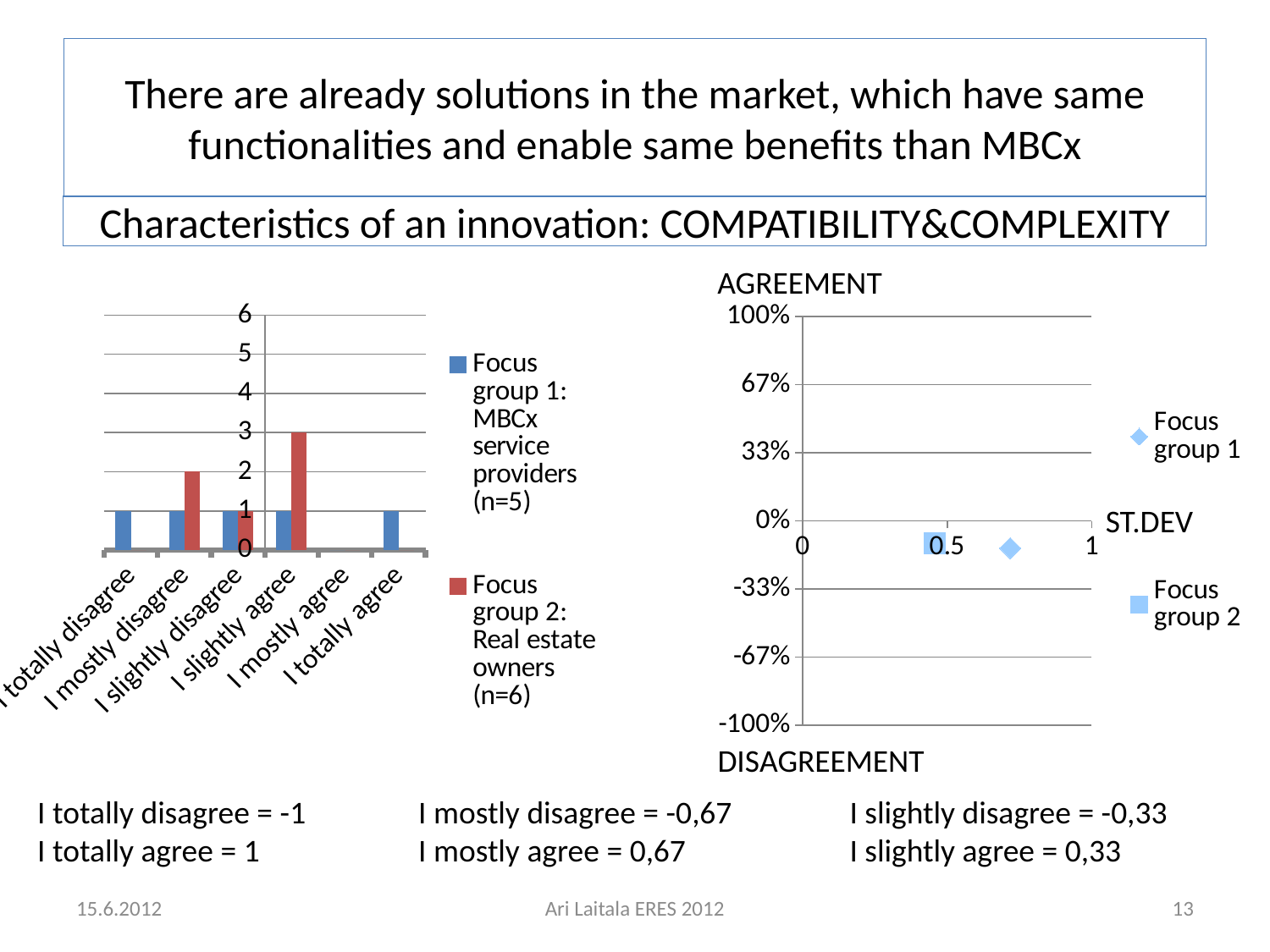
In the scatter chart on the right, is the ST.DEV value for Focus group 1 greater or less than 0.5? greater In the bar chart on the left, how many response categories are shown on the x axis? 6 In the scatter chart on the right, what label is shown at the top of the vertical axis? AGREEMENT In the bar chart on the left, what is the value for Focus group 2: Real estate owners (n=6) for 'I slightly agree'? 3 In the bar chart on the left, what is the value for Focus group 1: MBCx service providers (n=5) for 'I totally agree'? 1 In the bar chart on the left, what is the value for Focus group 2: Real estate owners (n=6) for 'I mostly disagree'? 2 What kind of chart is the chart on the left of the slide? bar chart In the bar chart on the left, what is the difference between the Focus group 2 values for 'I slightly agree' and 'I mostly disagree'? 1 In the bar chart on the left, which category has the highest value for Focus group 2: Real estate owners (n=6)? I slightly agree In the bar chart on the left, how many series does the legend list? 2 In the bar chart on the left, for 'I mostly disagree', which series has the larger value? Focus group 2: Real estate owners (n=6) What kind of chart is the chart on the right of the slide? scatter chart